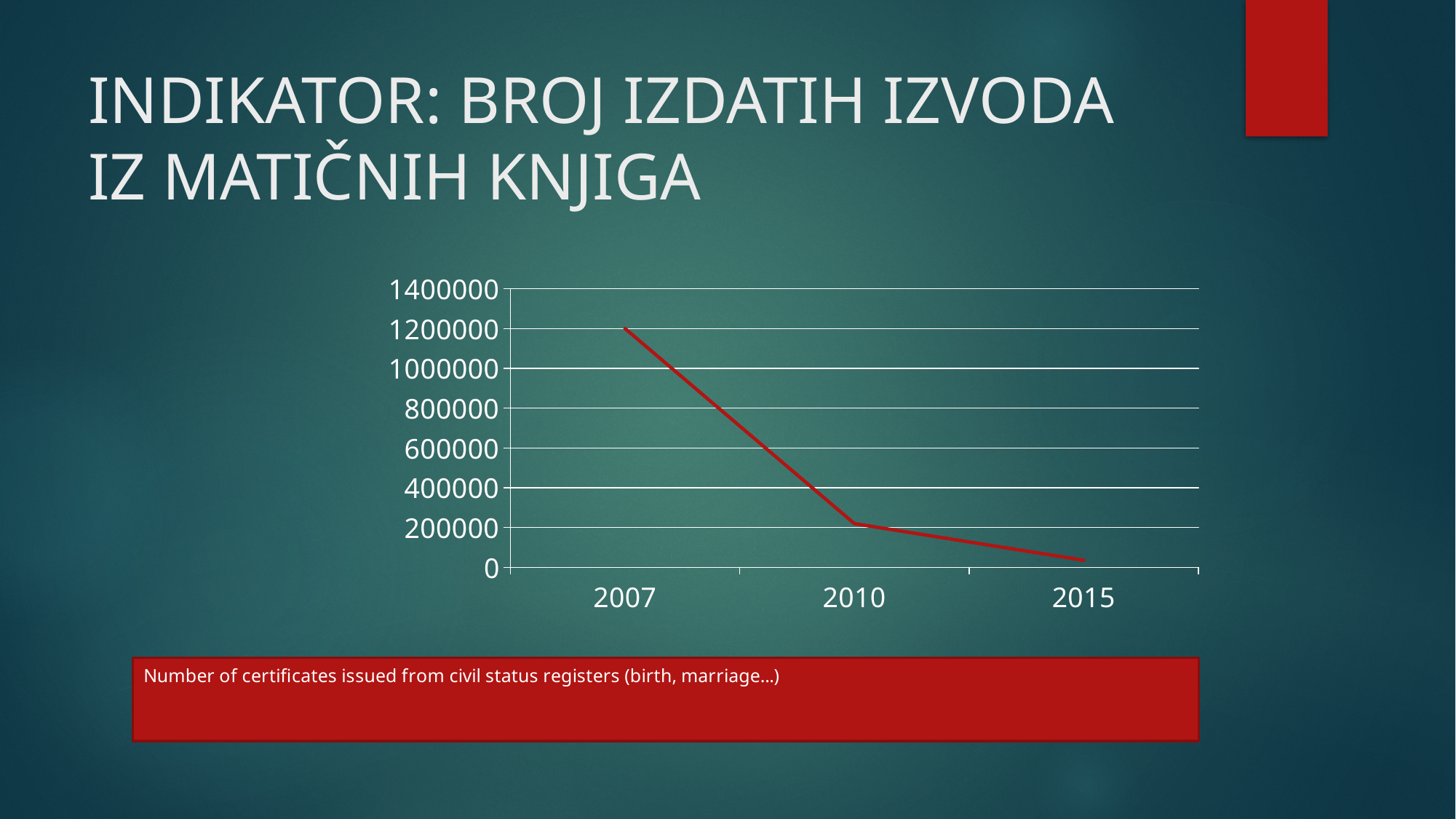
Do the values rise or fall from 2007 to 2015? fall How many data points are plotted on the line chart? 3 Which year has the lowest value on the chart? 2015 Is the value for 2010 greater or less than 400000? less What kind of chart is shown on the slide? line chart Is the value for 2015 greater or less than 200000? less Which year has the highest value on the chart? 2007 Which is larger, the value for 2010 or the value for 2015? 2010 What colour is the line in the chart? red Which years are labelled on the x axis of the chart? 2007, 2010, 2015 Is the value for 2007 greater or less than 1000000? greater What is the value for 2007? 1200000